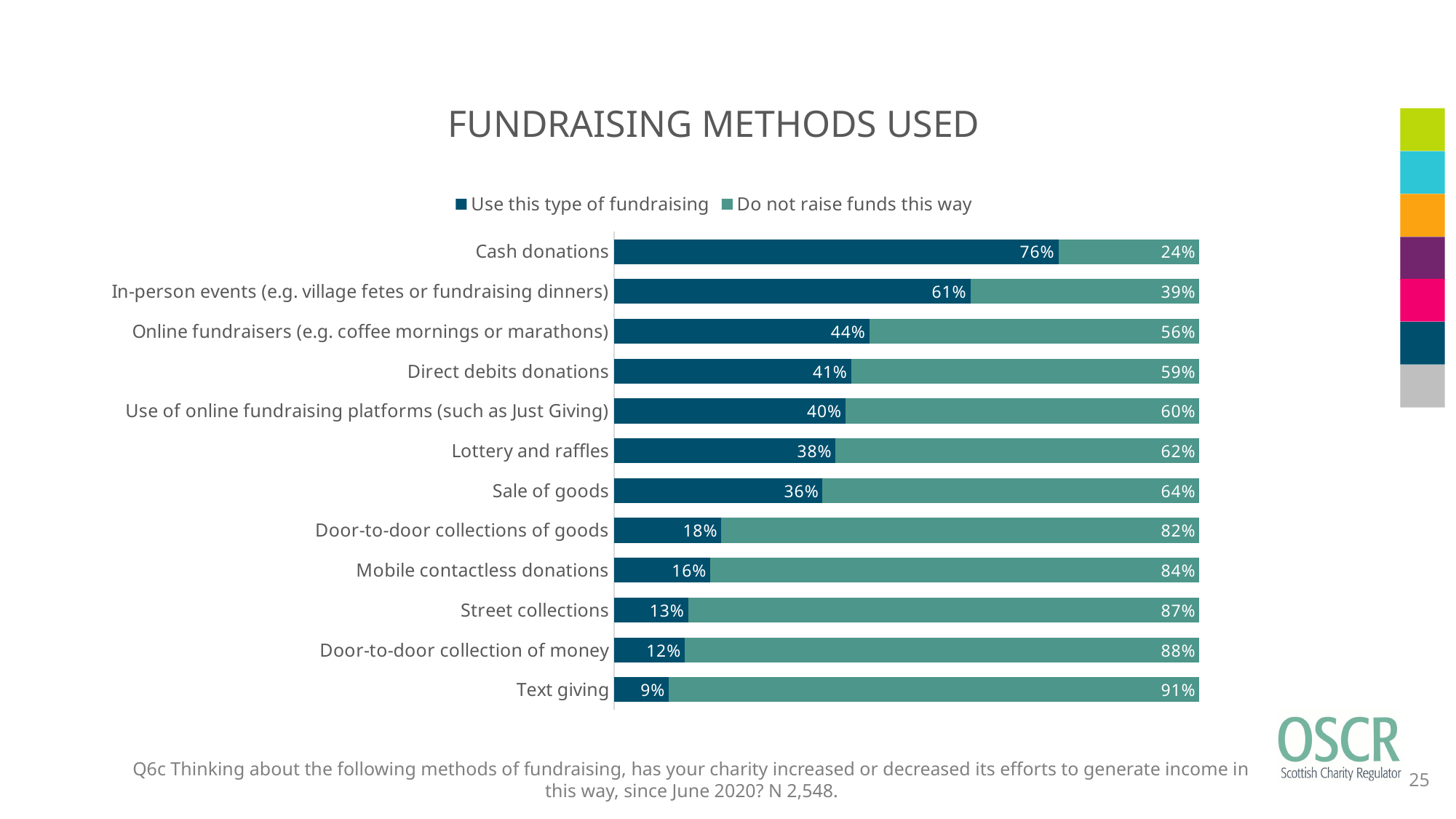
Which fundraising method has the highest 'Use this type of fundraising' value? Cash donations What percentage of charities use cash donations as a fundraising method? 76% Which has a higher 'Use this type of fundraising' value: Sale of goods or Door-to-door collections of goods? Sale of goods What kind of chart is shown on the slide? Stacked bar chart What percentage of charities do not raise funds through text giving? 91% What is the total of the two segments for the Street collections bar? 100% What is the 'Use this type of fundraising' value for Lottery and raffles? 38% What is the difference between the 'Use this type of fundraising' values for Cash donations and In-person events? 15% What is the title of the chart? FUNDRAISING METHODS USED Which fundraising method has the lowest 'Use this type of fundraising' value? Text giving How many series does the legend list? 2 How many fundraising methods are listed in the chart? 12